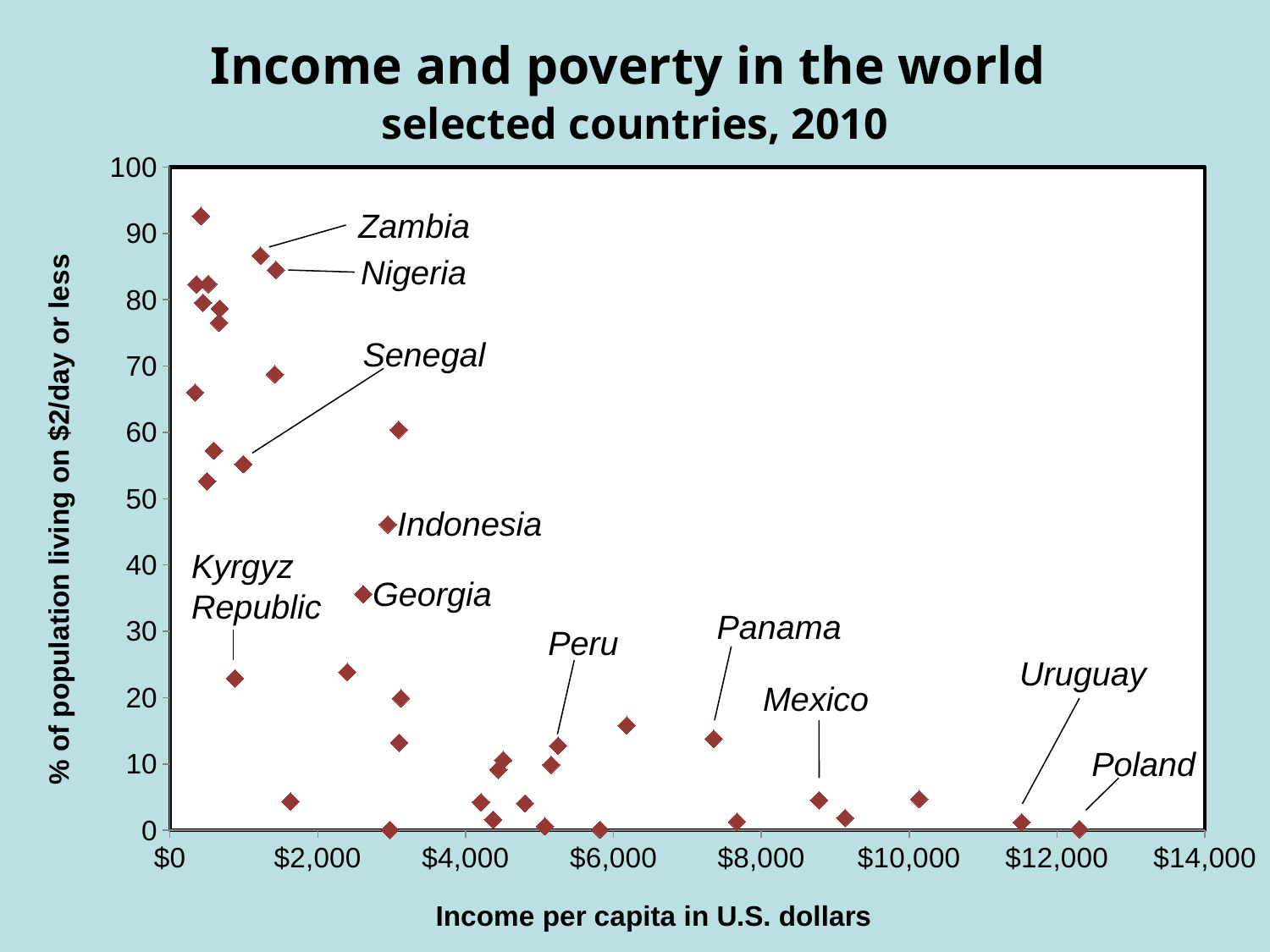
Is the percentage of population living on $2/day or less for Georgia greater or less than 40? less What kind of chart is shown on the slide? scatter chart Is the percentage of population living on $2/day or less for Indonesia greater or less than 40? greater What is the title of the chart? Income and poverty in the world, selected countries, 2010 Is the income per capita for Poland greater or less than $12,000? greater Which has a higher percentage of population living on $2/day or less, Zambia or Senegal? Zambia As income per capita increases along the x axis, does the percentage of population living on $2/day or less generally rise or fall? fall Which has a higher income per capita, Poland or Kyrgyz Republic? Poland What is the label of the x axis? Income per capita in U.S. dollars